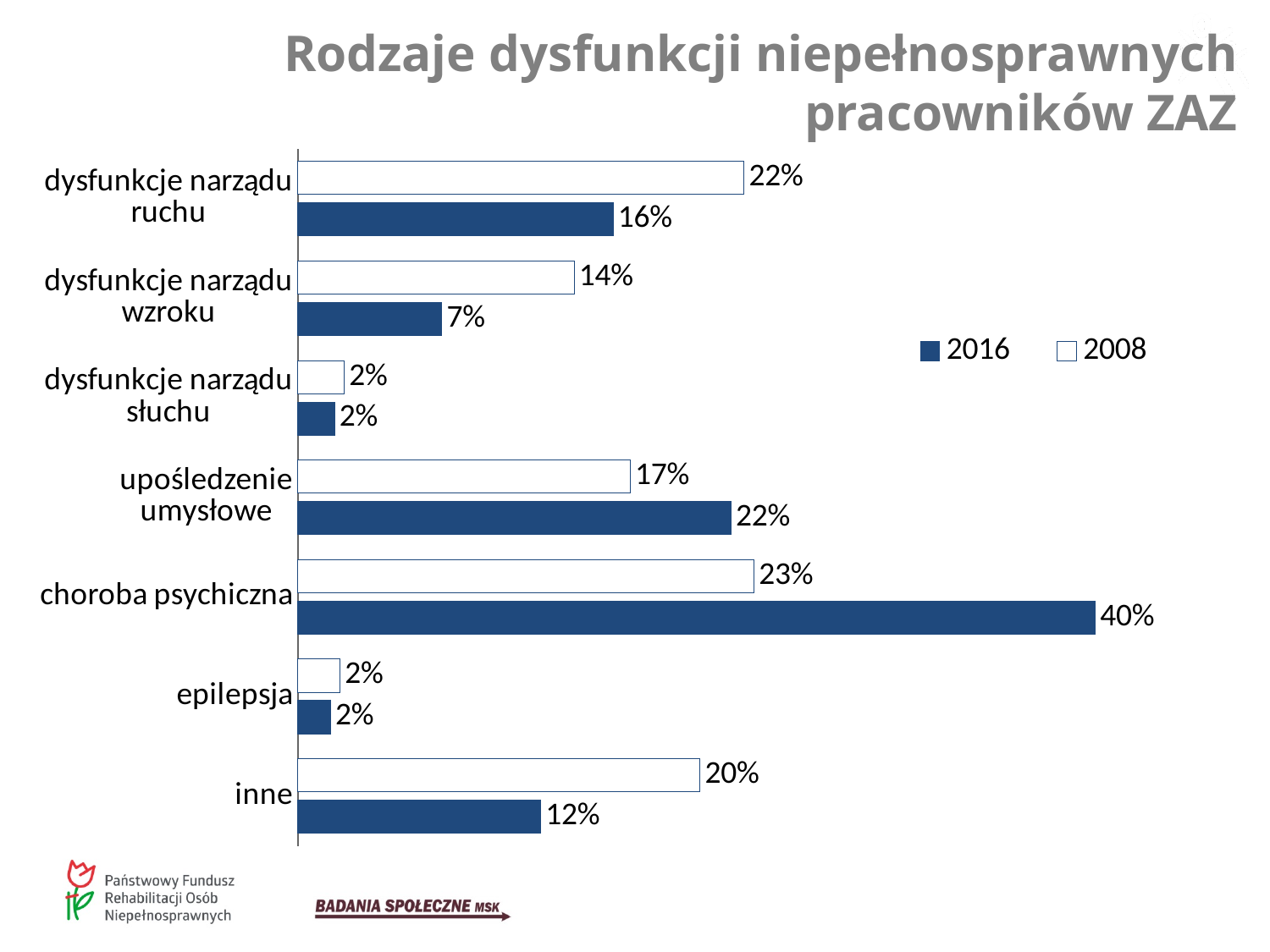
How many categories are shown on the chart? 7 What is the 2008 value for dysfunkcje narządu ruchu? 22% How many series does the legend list? 2 Which category has the highest 2008 value? choroba psychiczna Which category has the highest 2016 value? choroba psychiczna Which is larger for upośledzenie umysłowe, the 2016 value or the 2008 value? 2016 What is the 2016 value for dysfunkcje narządu wzroku? 7% What is the 2016 value for choroba psychiczna? 40% What kind of chart is shown on the slide? bar chart What is the difference between the 2008 and 2016 values for dysfunkcje narządu ruchu? 6% What is the difference between the 2016 and 2008 values for choroba psychiczna? 17% What is the 2008 value for inne? 20%